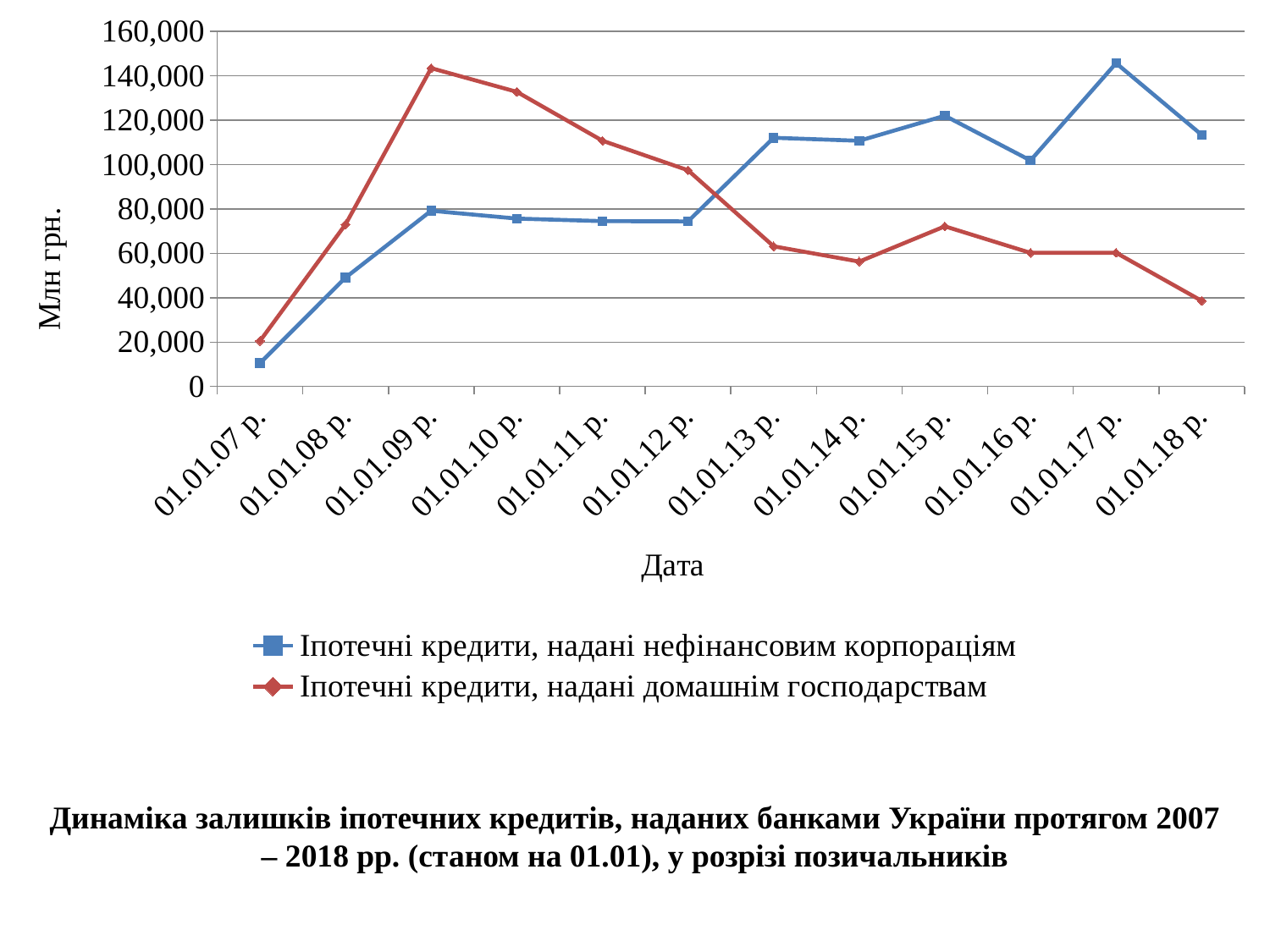
On which date does the series "Іпотечні кредити, надані нефінансовим корпораціям" reach its highest value? 01.01.17 р. Is the value for "Іпотечні кредити, надані нефінансовим корпораціям" at 01.01.18 р. greater or less than 100,000? greater Does the series "Іпотечні кредити, надані домашнім господарствам" rise or fall from 01.01.09 р. to 01.01.14 р.? Fall Is the value for "Іпотечні кредити, надані домашнім господарствам" at 01.01.09 р. greater or less than 140,000? greater On which date does the series "Іпотечні кредити, надані домашнім господарствам" reach its highest value? 01.01.09 р. What is the label of the vertical axis? Млн грн. On which date does the series "Іпотечні кредити, надані нефінансовим корпораціям" have its lowest value? 01.01.07 р. What kind of chart is shown on the slide? Line chart How many series does the legend list? 2 At 01.01.12 р., which series has the higher value? Іпотечні кредити, надані домашнім господарствам How many dates are plotted along the x axis? 12 On which date does the series "Іпотечні кредити, надані домашнім господарствам" have its lowest value? 01.01.07 р.